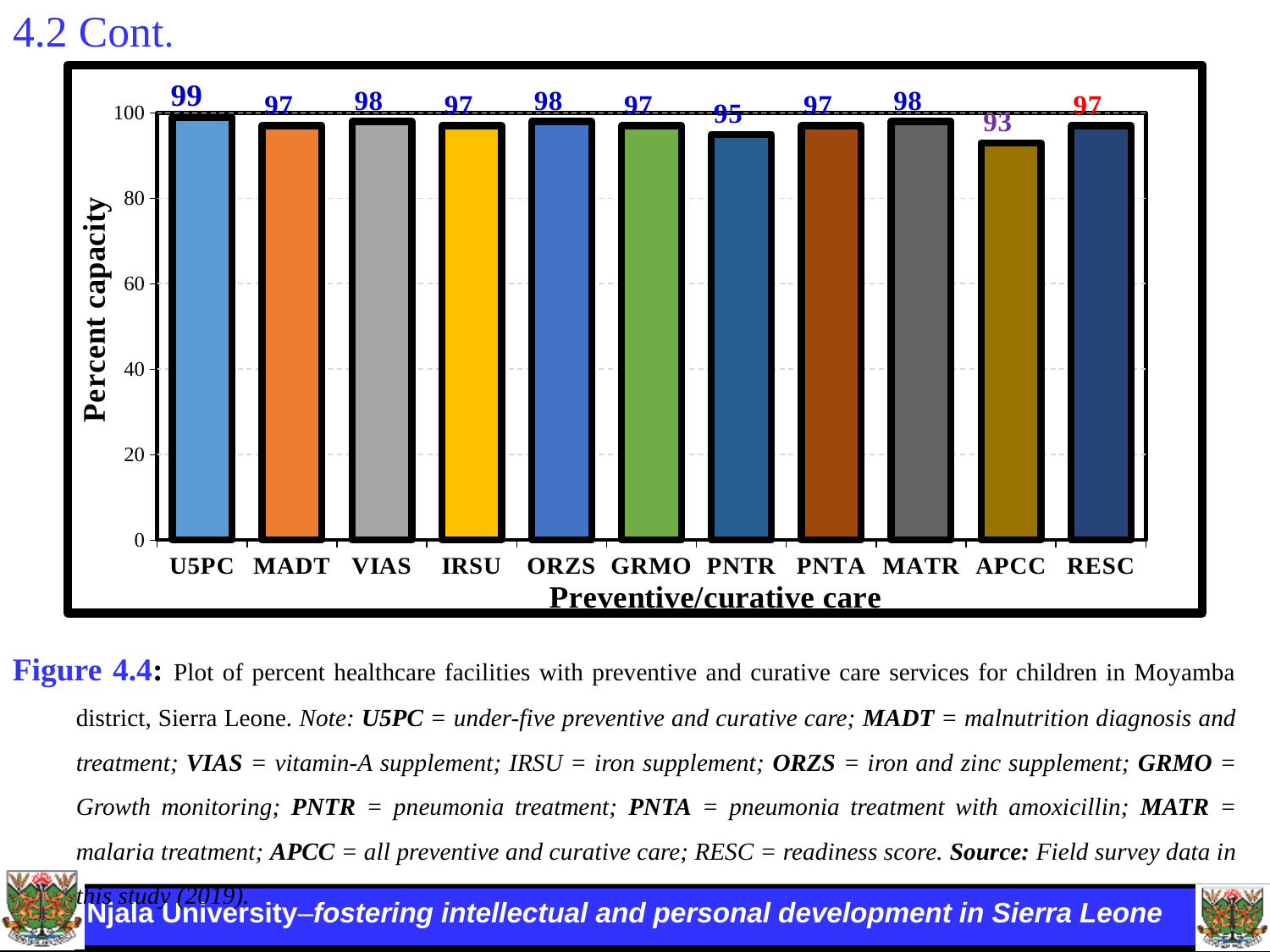
What is the value for U5PC? 99 What is the label of the y axis? Percent capacity What is the difference between the values for VIAS and PNTR? 3 What kind of chart is this? bar chart Which category has the highest value? U5PC Which is larger, the value for MATR or the value for APCC? MATR What is the value for RESC? 97 How many categories are shown on the x axis? 11 What is the value for APCC? 93 What is the value for PNTR? 95 Which category has the lowest value? APCC What is the difference between the values for U5PC and APCC? 6